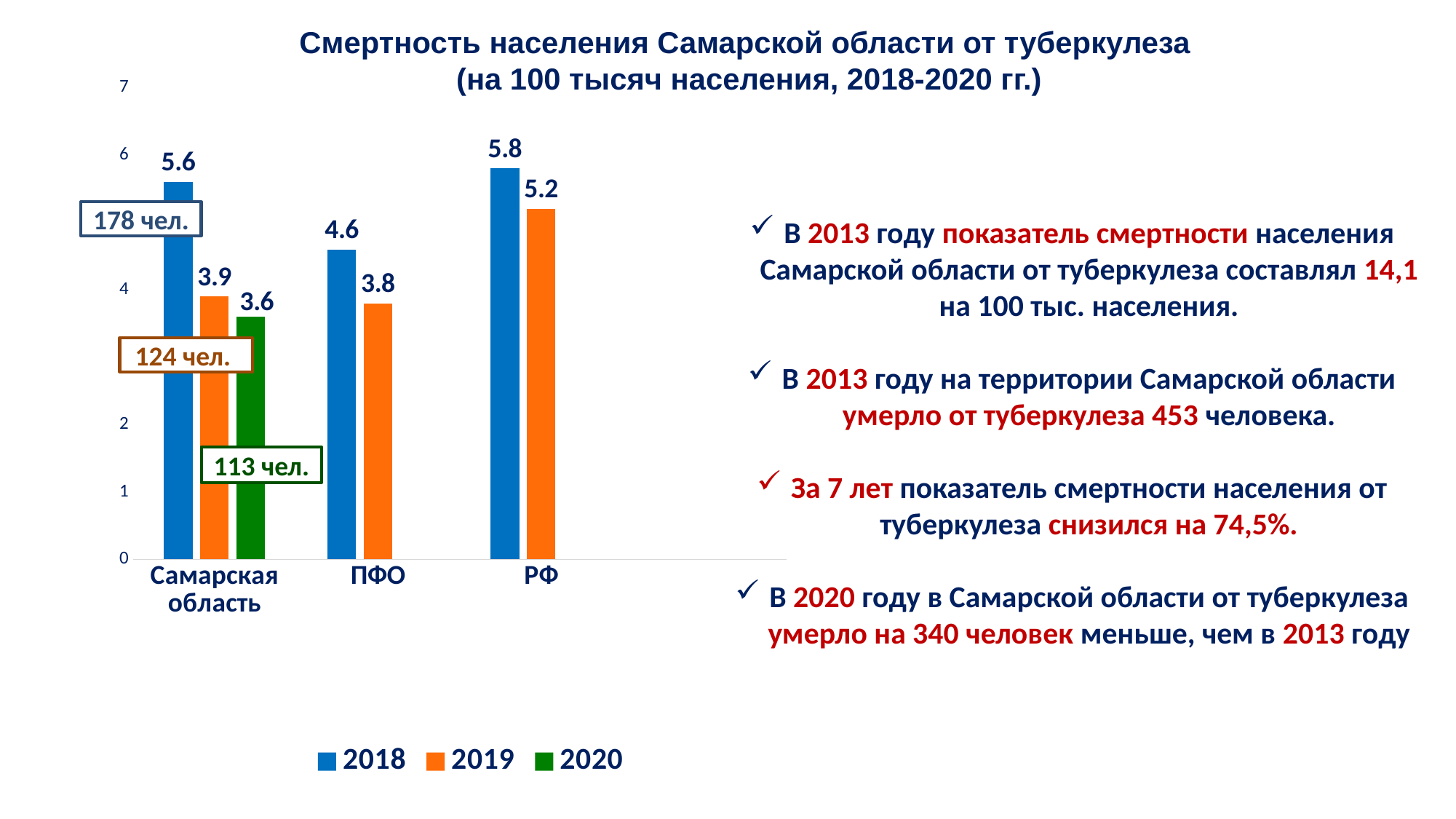
What kind of chart is shown? Bar chart What is the 2020 value for Самарская область? 3.6 What is the 2019 value for ПФО? 3.8 What is the 2019 value for РФ? 5.2 How many categories are shown on the x axis? 3 Which colour represents the 2020 series in the legend? Green What is the difference between the 2018 and 2019 values for Самарская область? 1.7 What is the 2018 value for Самарская область? 5.6 Which is larger, the 2018 value for ПФО or the 2019 value for РФ? 2019 value for РФ Which category has the lowest 2019 value? ПФО How many series does the legend list? 3 Which category has the highest 2018 value? РФ